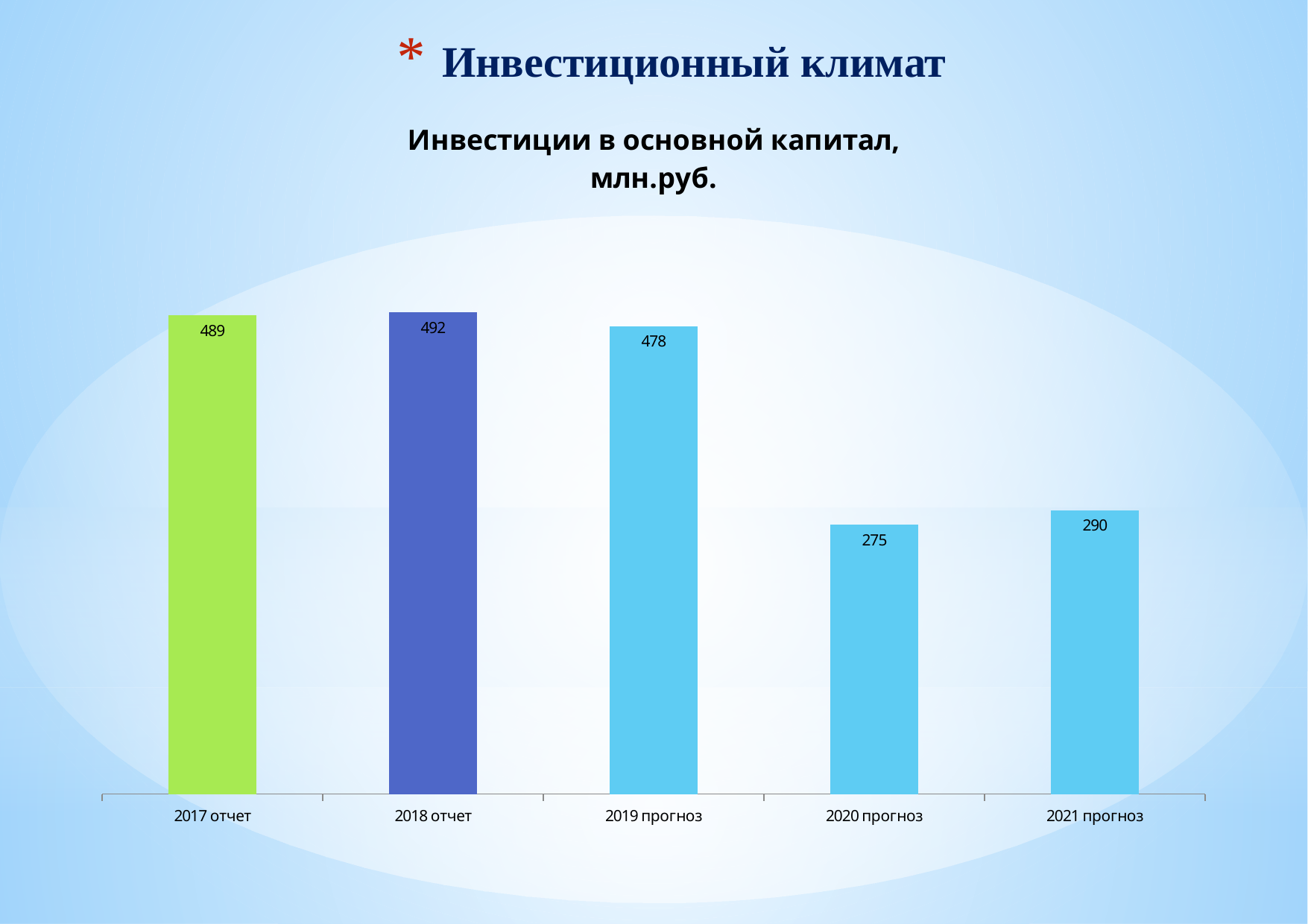
What is the title of the chart? Инвестиции в основной капитал, млн.руб. What is the value for 2018 отчет? 492 What kind of chart is shown on the slide? bar chart What is the value for 2021 прогноз? 290 Which is larger, the value for 2019 прогноз or the value for 2021 прогноз? 2019 прогноз What is the value for 2020 прогноз? 275 Which category has the highest value? 2018 отчет What is the difference between the values for 2018 отчет and 2020 прогноз? 217 What is the value for 2017 отчет? 489 How many categories are shown on the x axis? 5 Which category has the lowest value? 2020 прогноз What is the value for 2019 прогноз? 478